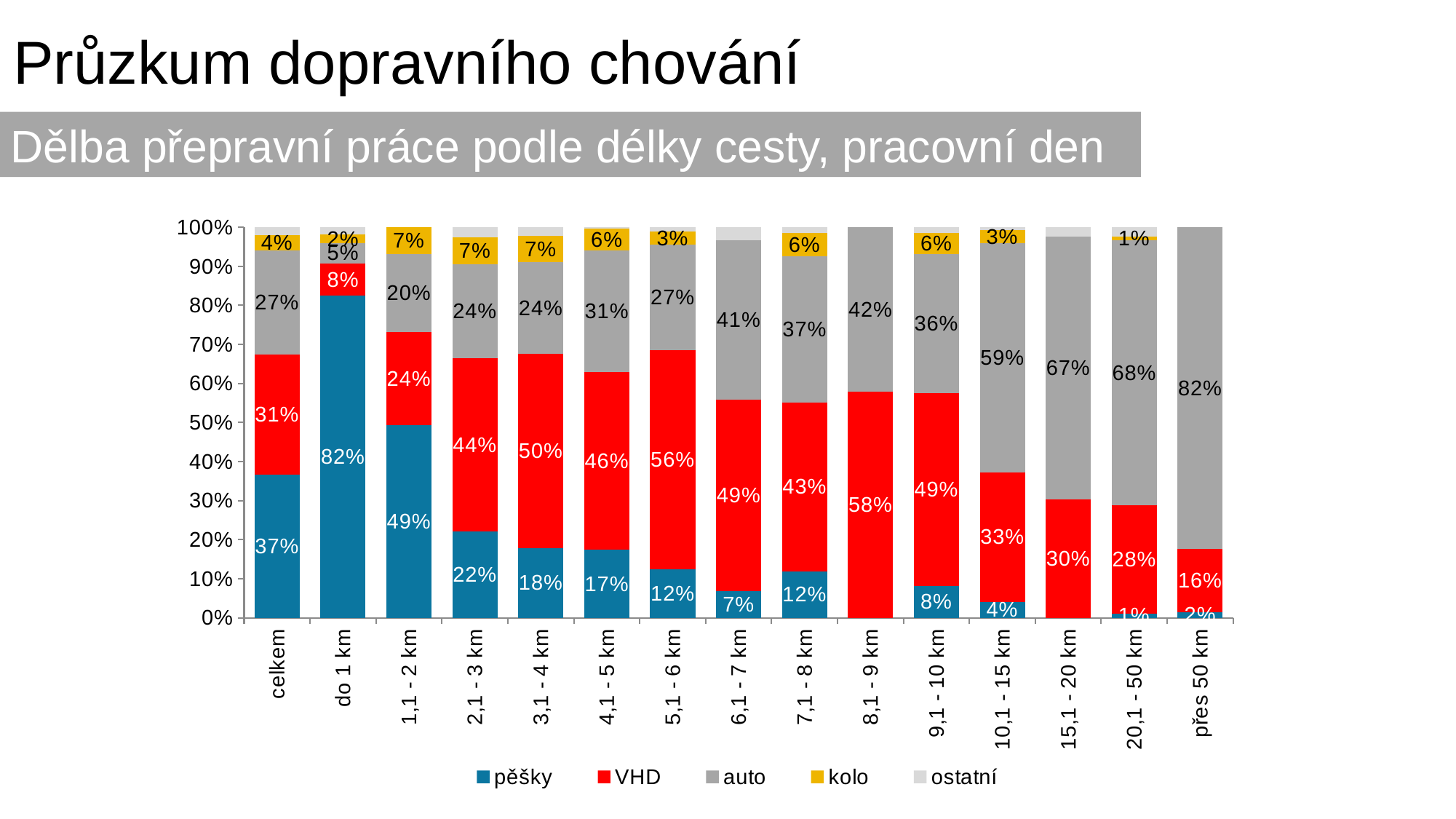
How many series does the legend list? 5 Which is larger: the VHD value for '5,1 - 6 km' or the VHD value for '10,1 - 15 km'? 5,1 - 6 km What is the value of pěšky for the category 'do 1 km'? 82% What is the value of VHD for the category 'celkem'? 31% How many categories are shown on the x axis? 15 What is the value of auto for the category 'přes 50 km'? 82% Which series is shown in red in the legend? VHD What kind of chart is shown on the slide? stacked bar chart What is the difference between the auto value for '20,1 - 50 km' and the auto value for '1,1 - 2 km'? 48% Does the auto share generally rise or fall as the trip length increases from 'do 1 km' to 'přes 50 km'? rise Which category has the highest value for pěšky? do 1 km Which category has the highest value for VHD? 8,1 - 9 km